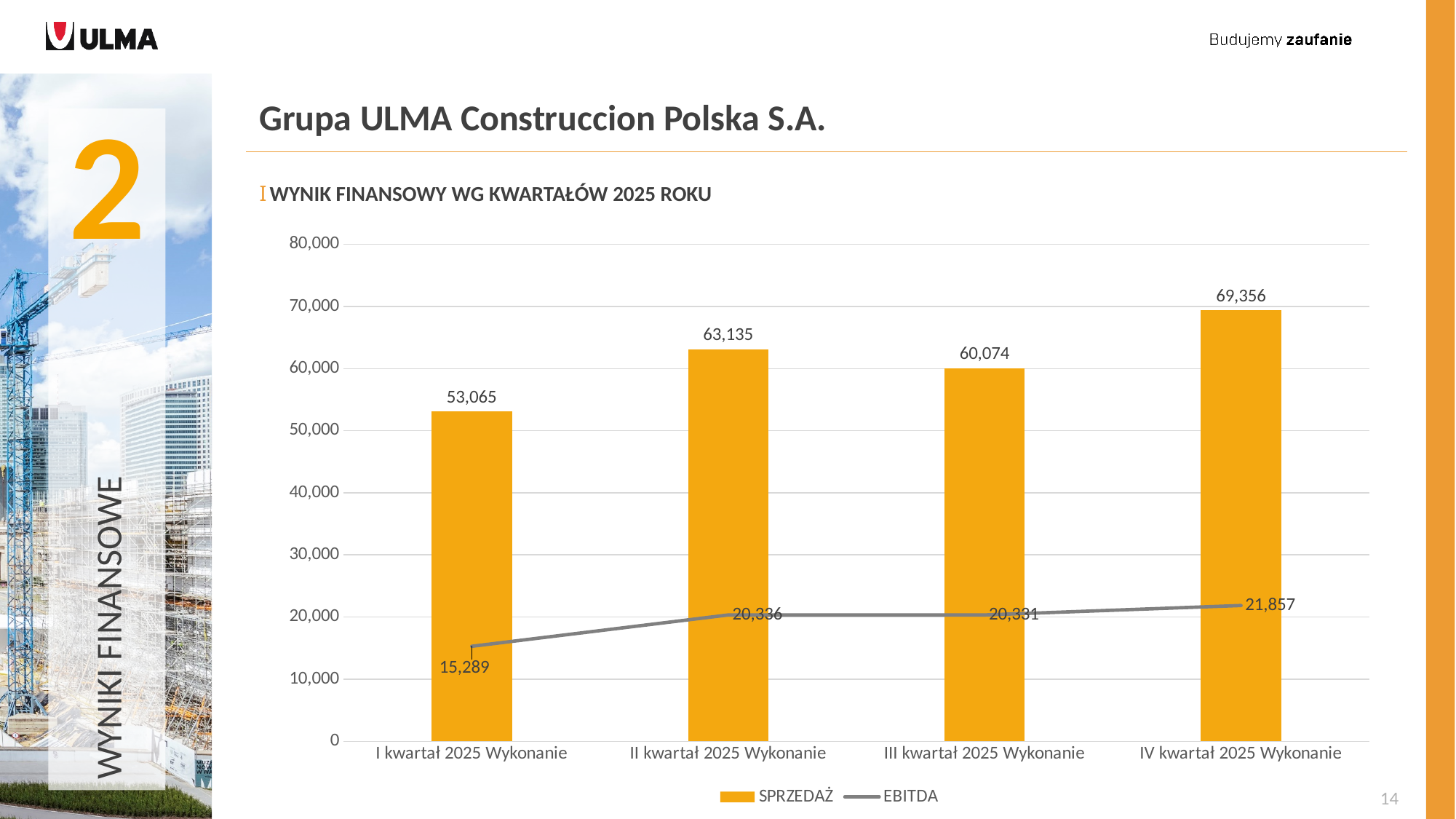
Which quarter has the lowest EBITDA value? I kwartał 2025 Wykonanie What is the SPRZEDAŻ value for III kwartał 2025 Wykonanie? 60,074 Which series is shown as a grey line in the chart? EBITDA What kind of chart is shown on the slide? Combined bar and line chart What is the difference between the SPRZEDAŻ values for IV kwartał 2025 Wykonanie and I kwartał 2025 Wykonanie? 16,291 Which is larger, the SPRZEDAŻ value for II kwartał 2025 Wykonanie or for III kwartał 2025 Wykonanie? II kwartał 2025 Wykonanie Which quarter has the highest SPRZEDAŻ value? IV kwartał 2025 Wykonanie What is the difference between the SPRZEDAŻ values for II kwartał 2025 Wykonanie and III kwartał 2025 Wykonanie? 3,061 What is the SPRZEDAŻ value for I kwartał 2025 Wykonanie? 53,065 What is the EBITDA value for IV kwartał 2025 Wykonanie? 21,857 How many quarters are shown on the x axis of the chart? 4 How many series does the chart legend list? 2